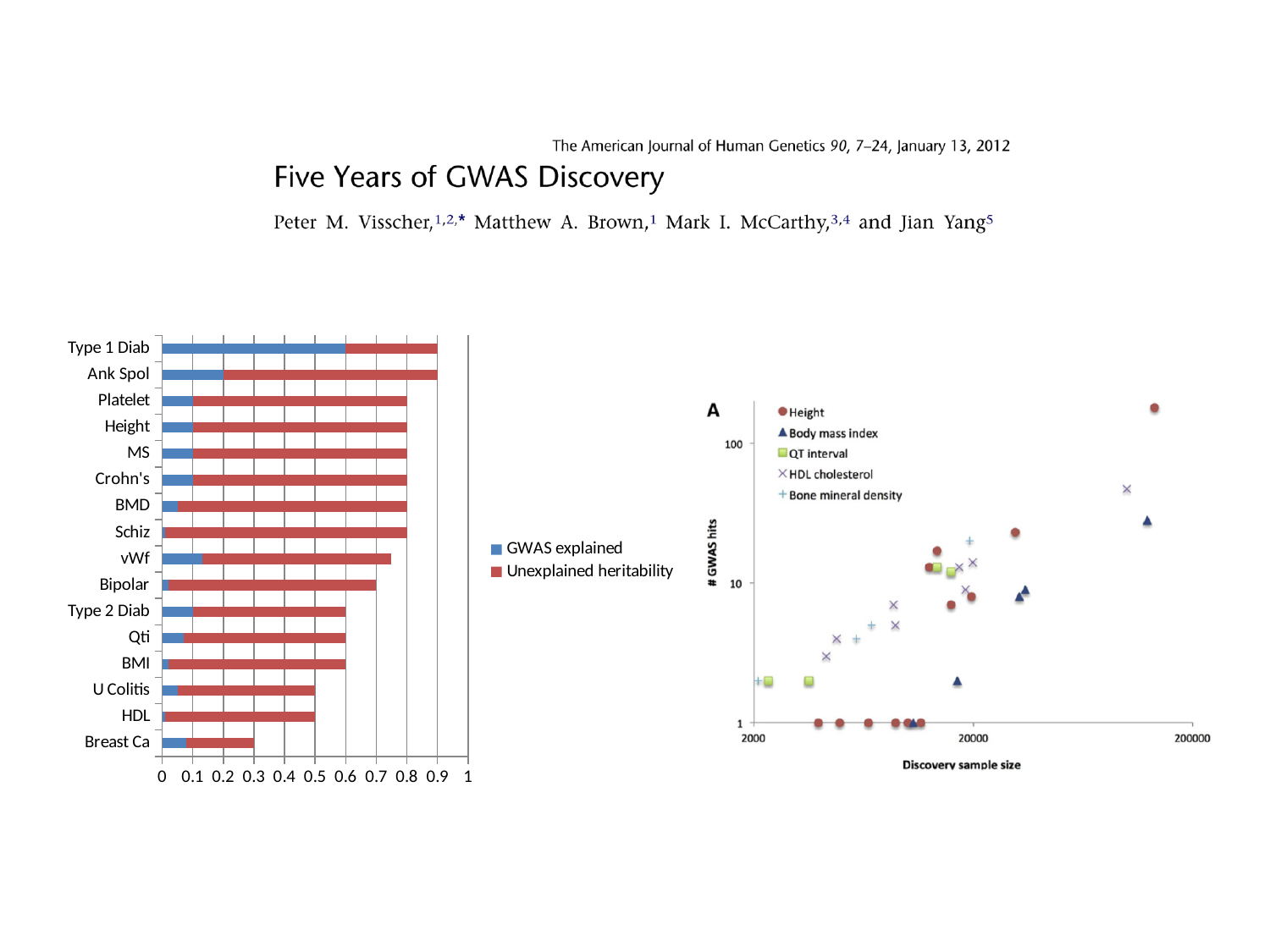
In the left bar chart, is the total bar for HDL greater or less than 0.6? less What kind of chart is the chart on the right of the slide? scatter chart In the left bar chart, is the GWAS explained segment larger for Type 1 Diab or for Ank Spol? Type 1 Diab In the left bar chart, is the total bar for Breast Ca greater or less than 0.5? less How many categories are shown on the left bar chart? 16 In the left bar chart, is the total bar for Type 1 Diab greater or less than 0.8? greater In the left bar chart, which category has the lowest total bar? Breast Ca What is the x-axis title of the right scatter chart? Discovery sample size What kind of chart is the chart on the left of the slide? bar chart In the left bar chart, which category has the largest GWAS explained segment? Type 1 Diab How many series does the legend of the right scatter chart list? 5 How many series does the legend of the left bar chart list? 2